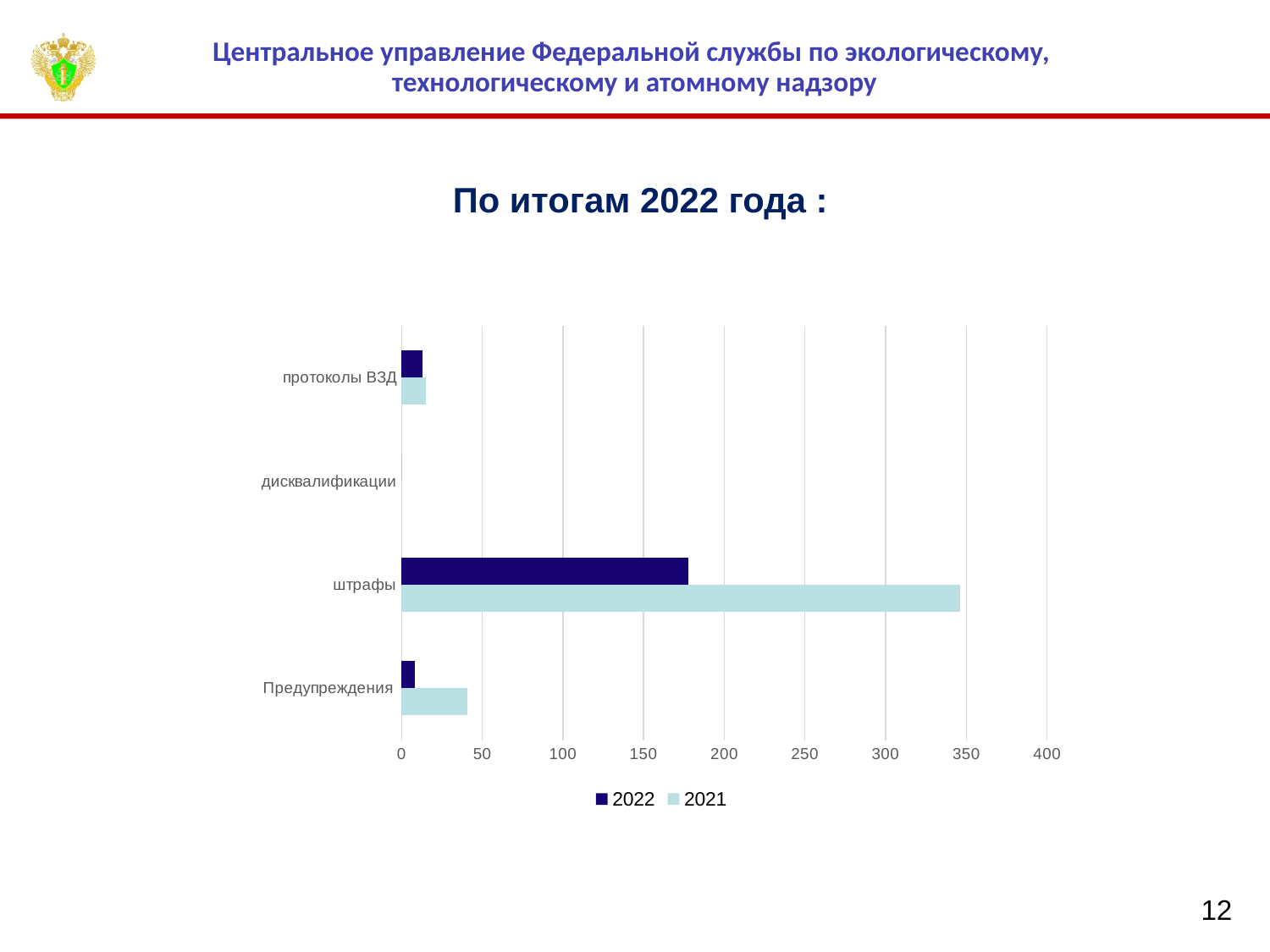
For штрафы, which series has the larger value, 2022 or 2021? 2021 What kind of chart is shown on the slide? bar chart For Предупреждения, which series has the larger value, 2022 or 2021? 2021 Is the 2022 value for штрафы greater or less than 200? less Which category has the highest value for the 2022 series? штрафы How many series does the legend list? 2 Is the 2021 value for Предупреждения greater or less than 50? less How many categories are shown on the chart? 4 Which category has the highest value for the 2021 series? штрафы What are the two series listed in the legend? 2022 and 2021 Is the 2022 value for штрафы greater or less than 150? greater